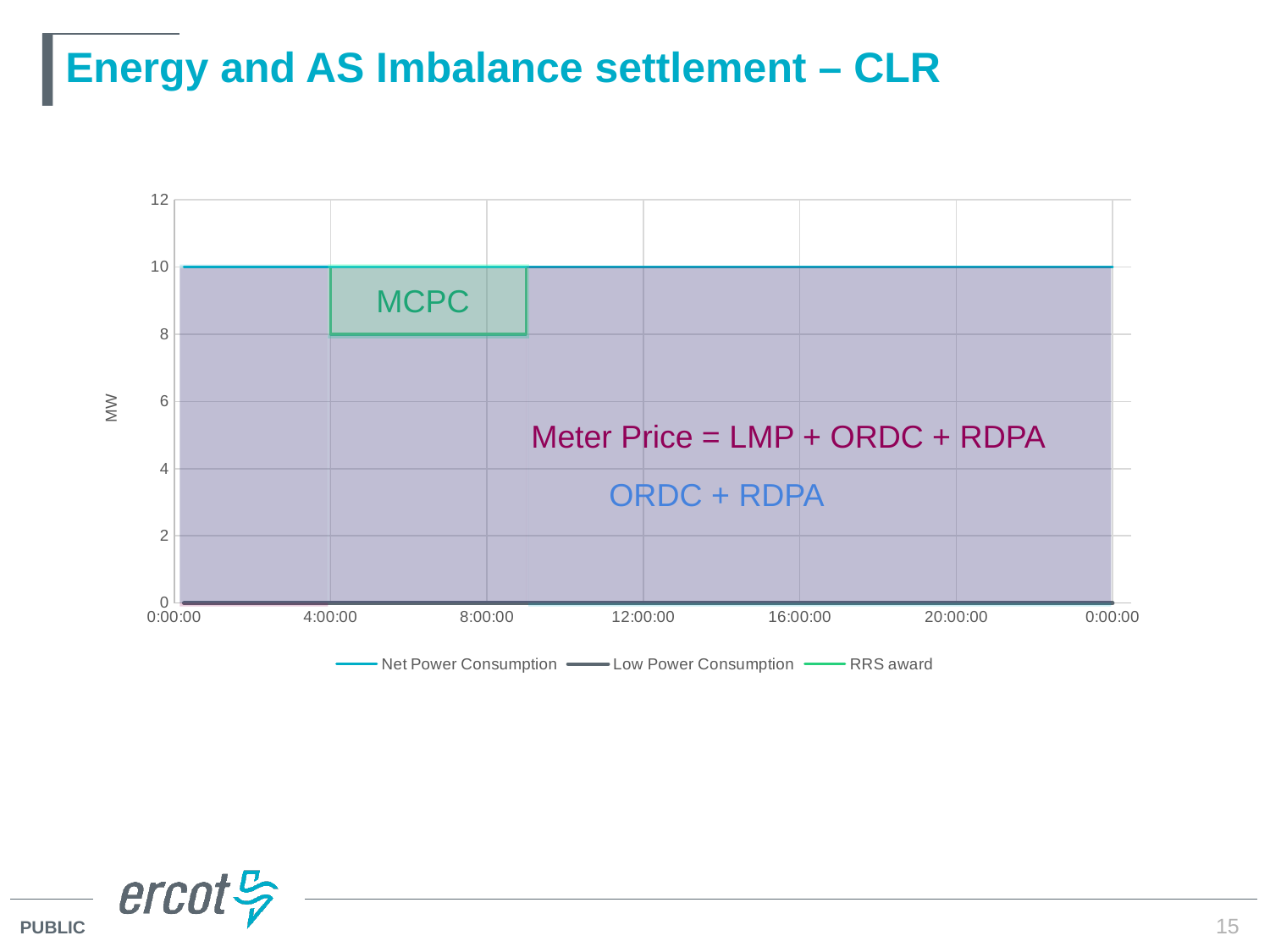
Is the lower edge of the RRS award band at 6:00:00 greater or less than 6? greater What is the label on the y axis? MW What is the difference between Net Power Consumption and Low Power Consumption at 12:00:00? 10 What value does the Net Power Consumption line hold at 12:00:00? 10 What is the highest value shown on the y axis? 12 Is the value of Net Power Consumption at 16:00:00 greater or less than 6? greater What kind of chart is shown on the slide? line chart Which is larger at 20:00:00, Net Power Consumption or Low Power Consumption? Net Power Consumption Does the Net Power Consumption line rise, fall, or stay flat from 0:00:00 to 0:00:00 the next day? stays flat What value does the Low Power Consumption line hold across the day? 0 How many series does the legend list? 3